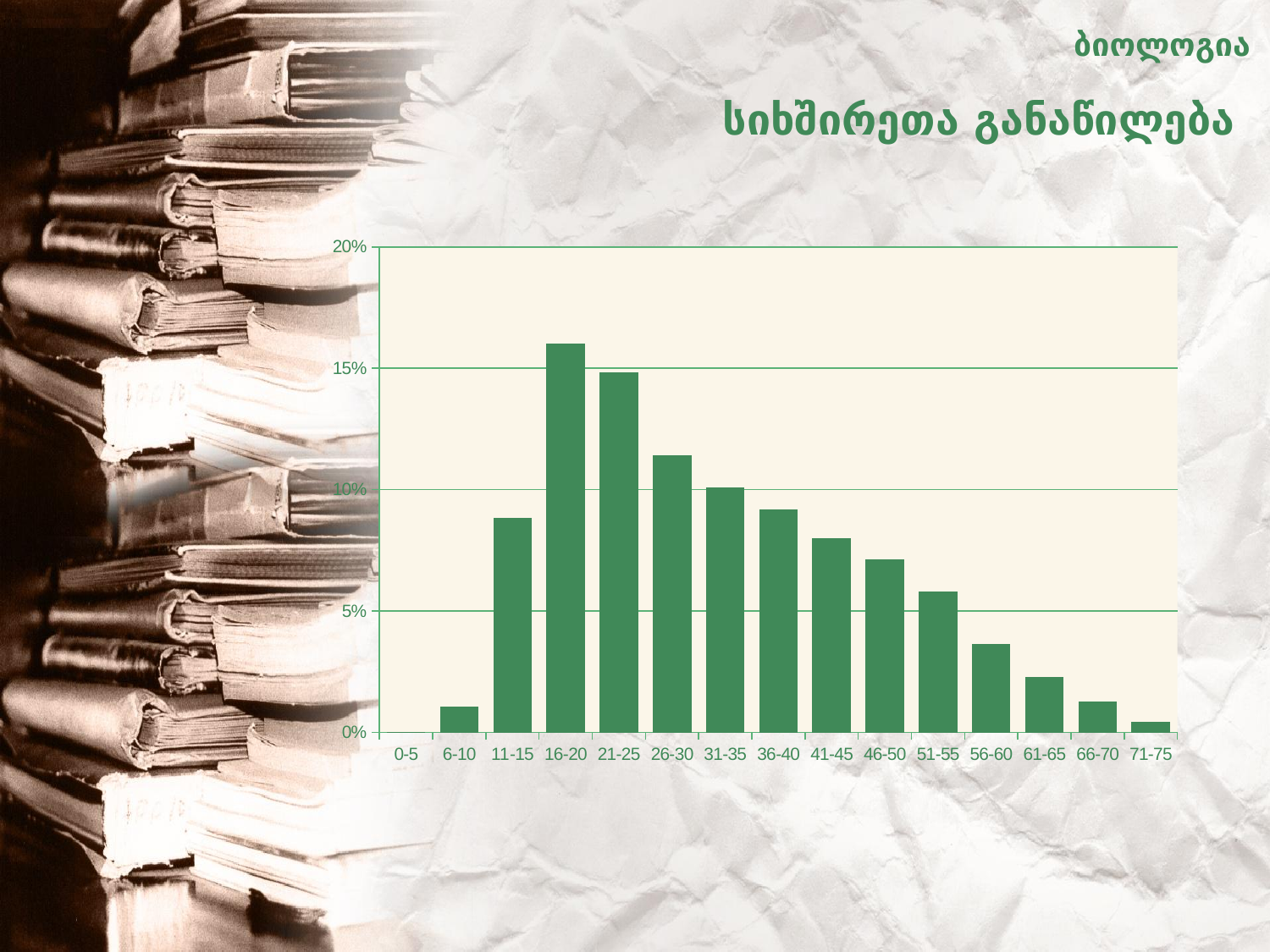
How many categories are shown on the x axis of the chart? 15 Is the value for 11-15 greater or less than 10%? less Is the value for 56-60 greater or less than 5%? less Which category has the highest value in the chart? 16-20 What is the title of the chart on the slide? სიხშირეთა განაწილება What kind of chart is shown on the slide? bar chart Do the values rise or fall along the x axis from 16-20 to 71-75? fall Which is larger, the value for 26-30 or the value for 41-45? 26-30 Is the value for 16-20 greater or less than 15%? greater Which is larger, the value for 16-20 or the value for 21-25? 16-20 Which category has the lowest value in the chart? 0-5